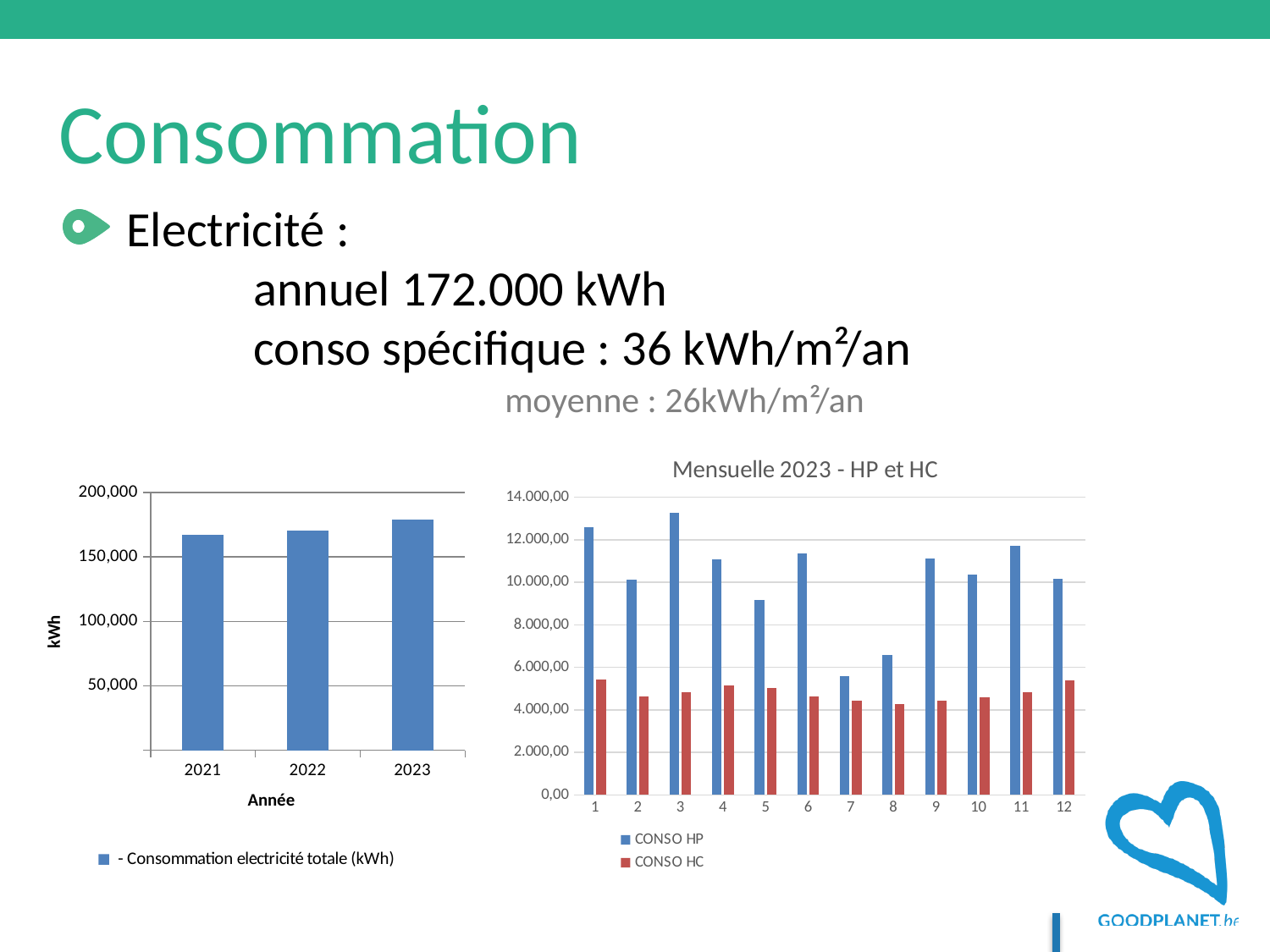
On the chart titled 'Mensuelle 2023 - HP et HC', which month has the lowest CONSO HP value? 7 On the chart titled 'Mensuelle 2023 - HP et HC', which month has the highest CONSO HP value? 3 On the chart titled 'Mensuelle 2023 - HP et HC', how many series does the legend list? 2 On the chart titled 'Mensuelle 2023 - HP et HC', is the CONSO HP value for month 7 greater or less than 6.000,00? less On the left chart, what is the label of the y axis? kWh What kind of chart is 'Mensuelle 2023 - HP et HC'? bar chart On the chart titled 'Mensuelle 2023 - HP et HC', is the CONSO HP value for month 1 greater or less than 12.000,00? greater On the chart titled 'Mensuelle 2023 - HP et HC', which is larger: the CONSO HP value for month 3 or for month 5? month 3 On the left chart, do the values rise or fall from 2021 to 2023? rise On the left chart, which year has the highest total electricity consumption? 2023 On the left chart, is the value for 2023 greater or less than 150,000? greater On the left chart, how many years are shown on the x axis? 3